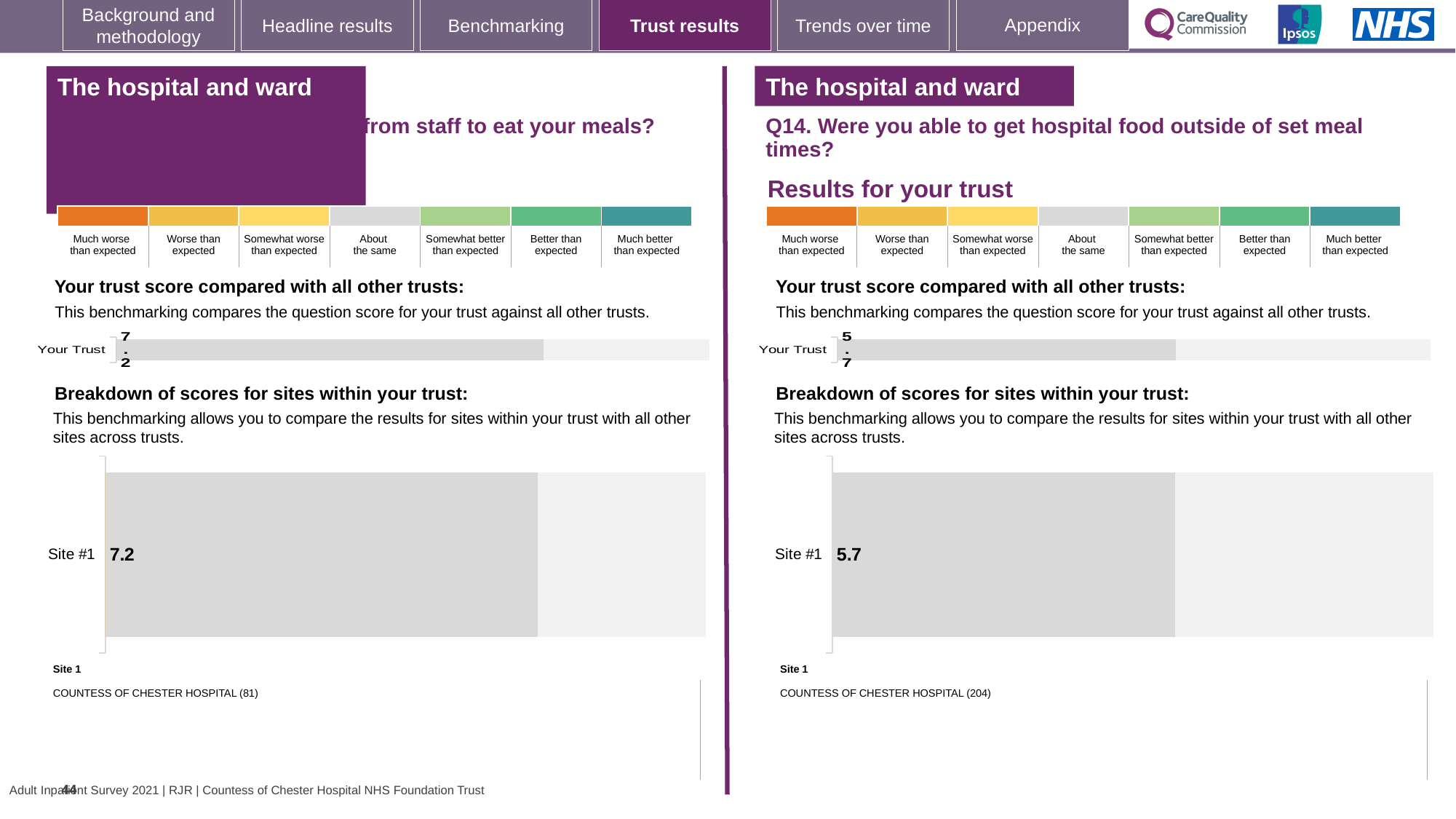
On the left-hand breakdown chart, what is the name of the site listed as Site 1 below the chart? COUNTESS OF CHESTER HOSPITAL (81) On the right-hand (Q14) 'Your trust score compared with all other trusts' chart, what is the value shown for Your Trust? 5.7 How many sites are plotted on the left-hand 'Breakdown of scores for sites within your trust' chart? 1 What is the difference between the Site #1 score on the left-hand breakdown chart and the Site #1 score on the right-hand Q14 breakdown chart? 1.5 On the right-hand (Q14) 'Breakdown of scores for sites within your trust' chart, what is the value shown for Site #1? 5.7 On the left-hand 'Breakdown of scores for sites within your trust' chart, what is the value shown for Site #1? 7.2 How many sites are plotted on the right-hand (Q14) 'Breakdown of scores for sites within your trust' chart? 1 On the right-hand (Q14) breakdown chart, what is the name of the site listed as Site 1 below the chart? COUNTESS OF CHESTER HOSPITAL (204) What kind of chart is used to show the Site #1 score on the right-hand (Q14) breakdown chart? Bar chart Which is larger: the Your Trust score on the left-hand chart or the Your Trust score on the right-hand Q14 chart? The left-hand chart (7.2) On the left-hand 'Your trust score compared with all other trusts' chart, what is the value shown for Your Trust? 7.2 What kind of chart is used to show the Your Trust score on the left-hand 'Your trust score compared with all other trusts' chart? Bar chart